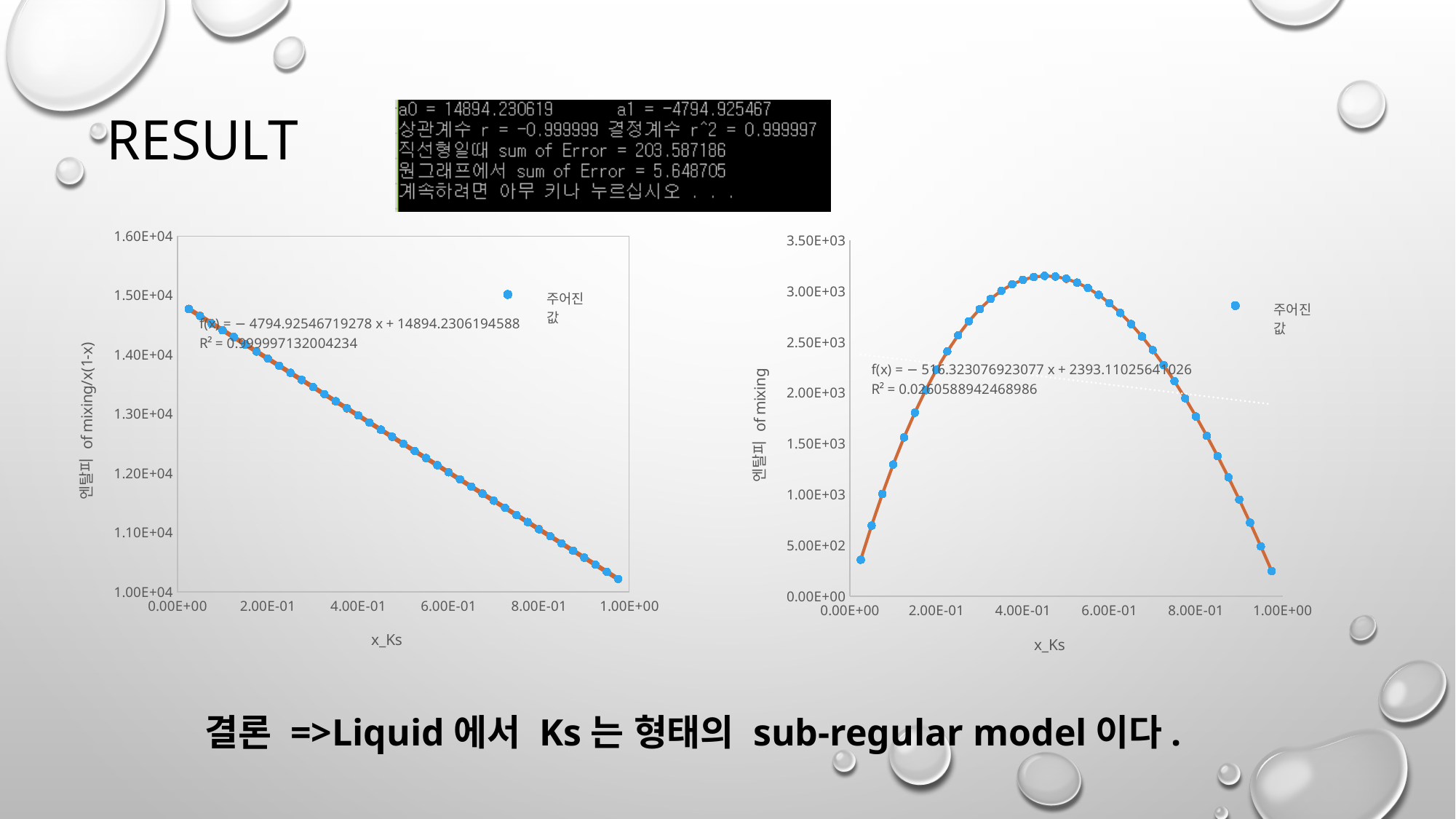
In the left chart, is the value at x_Ks = 2.00E-01 greater or less than 1.30E+04? greater In the left chart, do the plotted values rise or fall as x_Ks increases? fall In the left chart, is the value at x_Ks = 8.00E-01 greater or less than 1.20E+04? less In the right chart, how do the plotted values change as x_Ks increases from 0 to 1? rise then fall What is the x-axis title of the left chart? x_Ks In the right chart, is the value at x_Ks = 1.00E-01 greater or less than 1.00E+03? greater How many series does the legend of the left chart list? 1 What kind of chart is the left chart (엔탈피 of mixing/x(1-x) vs x_Ks)? scatter chart What is the legend entry shown in the right chart? 주어진 값 What kind of chart is the right chart (엔탈피 of mixing vs x_Ks)? scatter chart